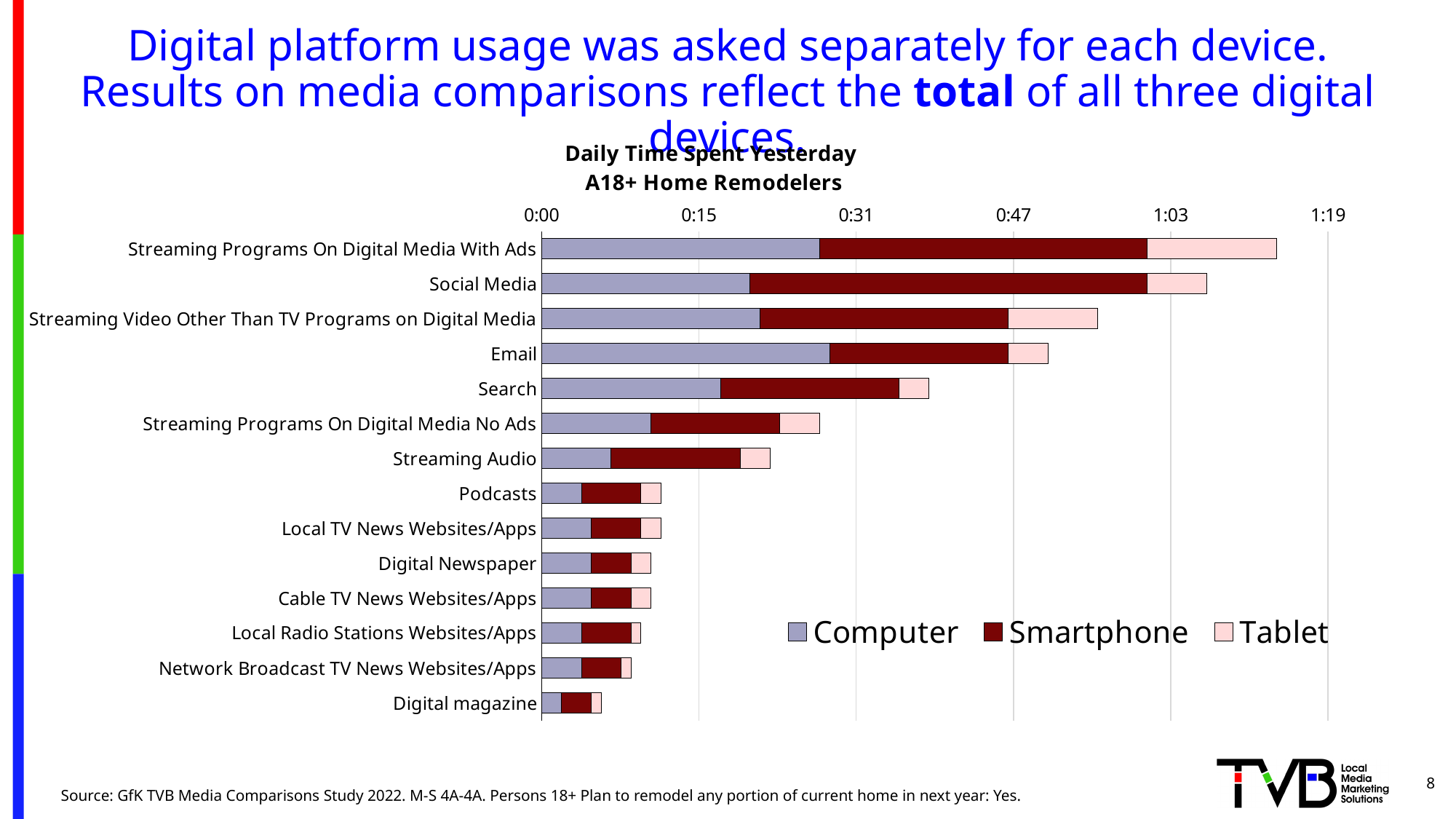
Do the total bar lengths generally increase or decrease going down the list of categories? decrease Which category has the longest total bar? Streaming Programs On Digital Media With Ads What kind of chart is shown on the slide? Stacked bar chart How many series does the legend list? 3 What is the title of the chart? Daily Time Spent Yesterday A18+ Home Remodelers Which has the larger total bar, Social Media or Email? Social Media Which category has the shortest total bar? Digital magazine Is the total bar for Podcasts greater or less than 0:15? less Is the total bar for Streaming Audio greater or less than 0:15? greater Is the total bar for Streaming Programs On Digital Media With Ads greater or less than 1:03? greater How many categories are plotted in the chart? 14